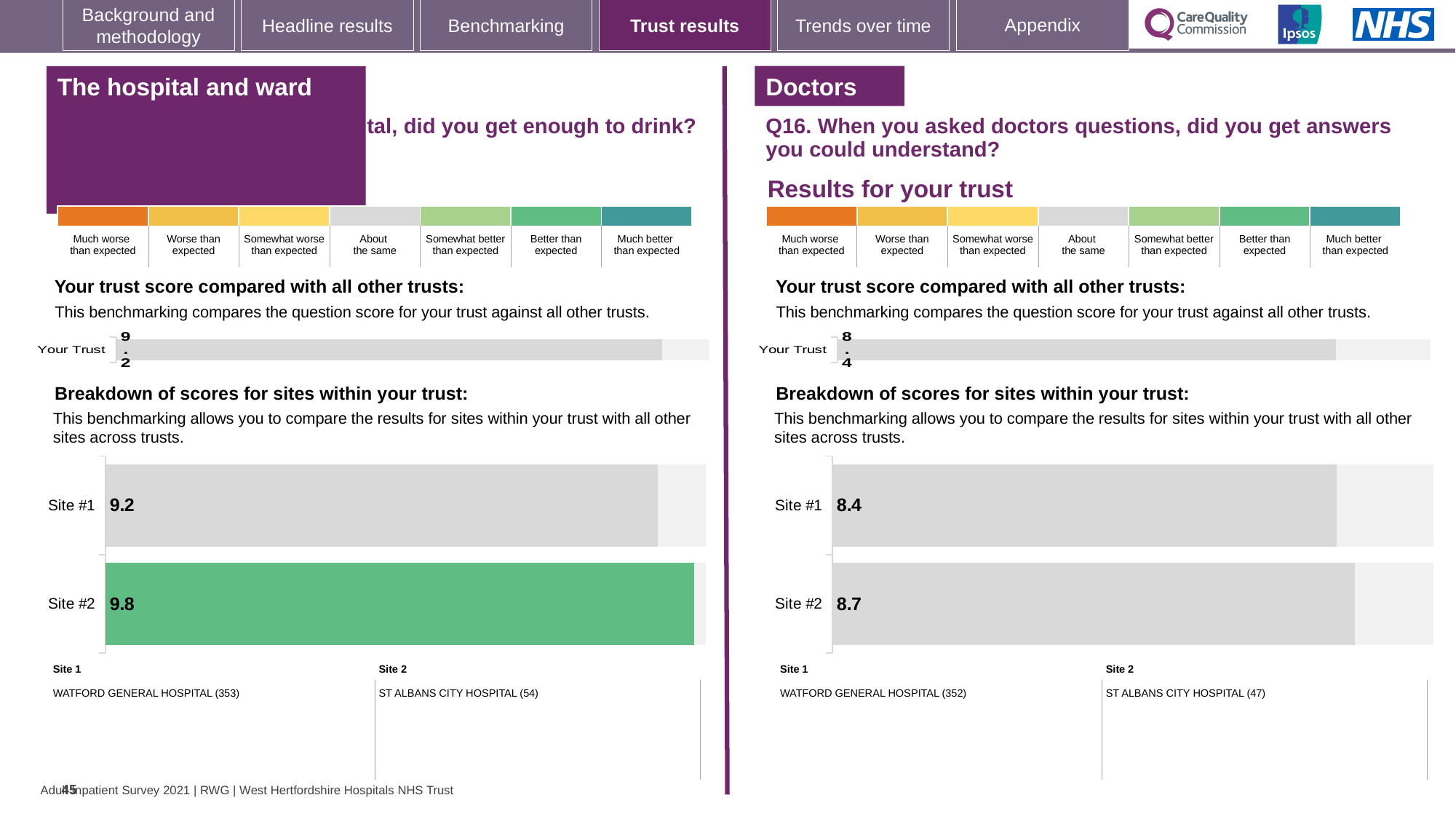
In the 'Your trust score compared with all other trusts' chart on the right-hand side of the slide (Doctors, Q16), what is the score for Your Trust? 8.4 In the 'Breakdown of scores for sites within your trust' chart on the right-hand side of the slide (Doctors, Q16), what is the score for Site #2? 8.7 In the site breakdown chart on the right-hand side of the slide (Doctors, Q16), what is the difference between the Site #2 and Site #1 scores? 0.3 In the site breakdown chart on the left-hand side of the slide (The hospital and ward), what is the difference between the Site #2 and Site #1 scores? 0.6 In the site breakdown chart on the right-hand side of the slide (Doctors, Q16), which site has the lower score? Site #1 In the site breakdown chart on the left-hand side of the slide (The hospital and ward), which site has the higher score? Site #2 In the 'Your trust score compared with all other trusts' chart on the left-hand side of the slide (The hospital and ward), what is the score for Your Trust? 9.2 What type of chart is used for the site breakdown on the left-hand side of the slide (The hospital and ward)? Bar chart In the 'Breakdown of scores for sites within your trust' chart on the left-hand side of the slide (The hospital and ward), what is the score for Site #2? 9.8 How many sites are shown in the site breakdown chart on the right-hand side of the slide (Doctors, Q16)? 2 In the 'Breakdown of scores for sites within your trust' chart on the right-hand side of the slide (Doctors, Q16), what is the score for Site #1? 8.4 In the 'Breakdown of scores for sites within your trust' chart on the left-hand side of the slide (The hospital and ward), what is the score for Site #1? 9.2